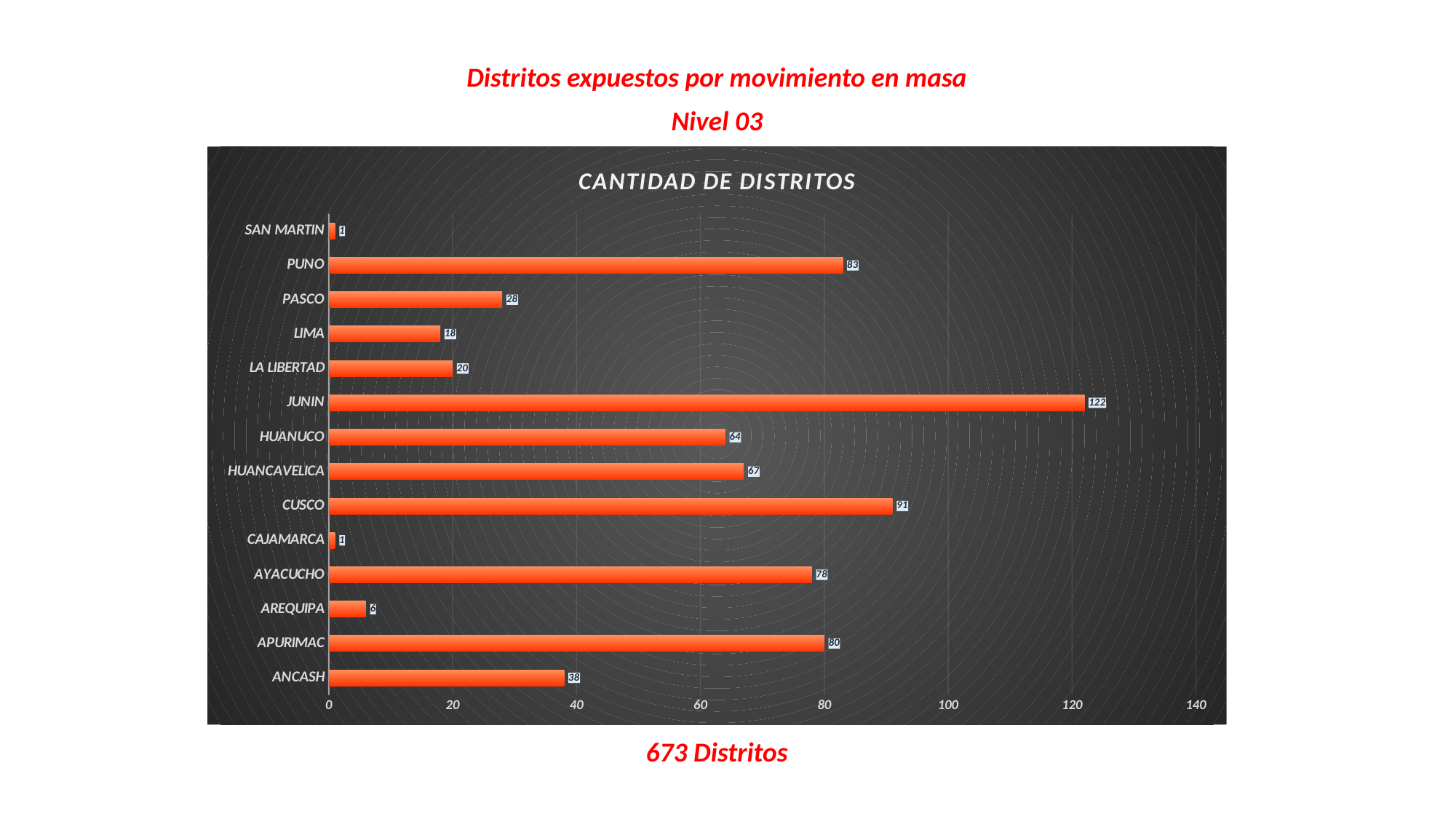
What is the value for AREQUIPA? 6 What is the value for LA LIBERTAD? 20 What type of chart is shown on the slide? bar chart Which has a larger value, HUANCAVELICA or HUANUCO? HUANCAVELICA What is the title of the chart? CANTIDAD DE DISTRITOS What is the difference between the values for PUNO and APURIMAC? 3 Which region has the highest value? JUNIN What is the difference between the values for JUNIN and CUSCO? 31 What is the value for CUSCO? 91 How many categories (regions) are plotted in the chart? 14 Is the value for AYACUCHO greater or less than 60? greater What is the value for JUNIN? 122